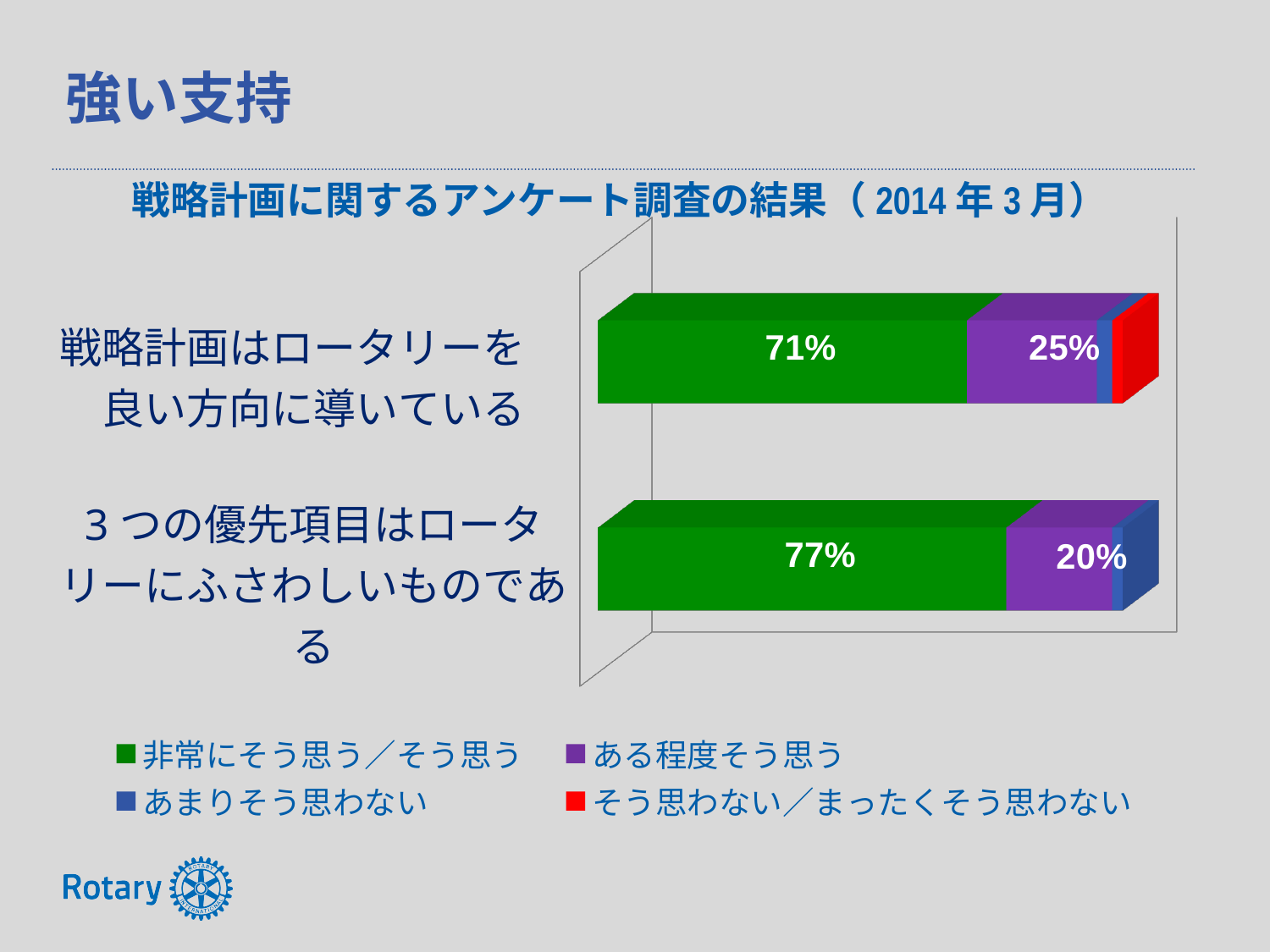
What percentage of respondents answered ある程度そう思う for 戦略計画はロータリーを良い方向に導いている? 25% Which statement has the higher share of 非常にそう思う／そう思う responses? ３つの優先項目はロータリーにふさわしいものである How many response categories does the legend list? 4 What percentage of respondents answered 非常にそう思う／そう思う for ３つの優先項目はロータリーにふさわしいものである? 77% What percentage of respondents answered 非常にそう思う／そう思う for 戦略計画はロータリーを良い方向に導いている? 71% How many statements (categories) are shown in the chart? 2 Which statement has the lower share of ある程度そう思う responses? ３つの優先項目はロータリーにふさわしいものである What kind of chart is shown on the slide? Stacked bar chart Is the ある程度そう思う share larger for 戦略計画はロータリーを良い方向に導いている or for ３つの優先項目はロータリーにふさわしいものである? 戦略計画はロータリーを良い方向に導いている What is the difference in percentage points between the 非常にそう思う／そう思う shares of the two statements? 6 percentage points What percentage of respondents answered ある程度そう思う for ３つの優先項目はロータリーにふさわしいものである? 20% What is the title of the chart? 戦略計画に関するアンケート調査の結果（2014年3月）